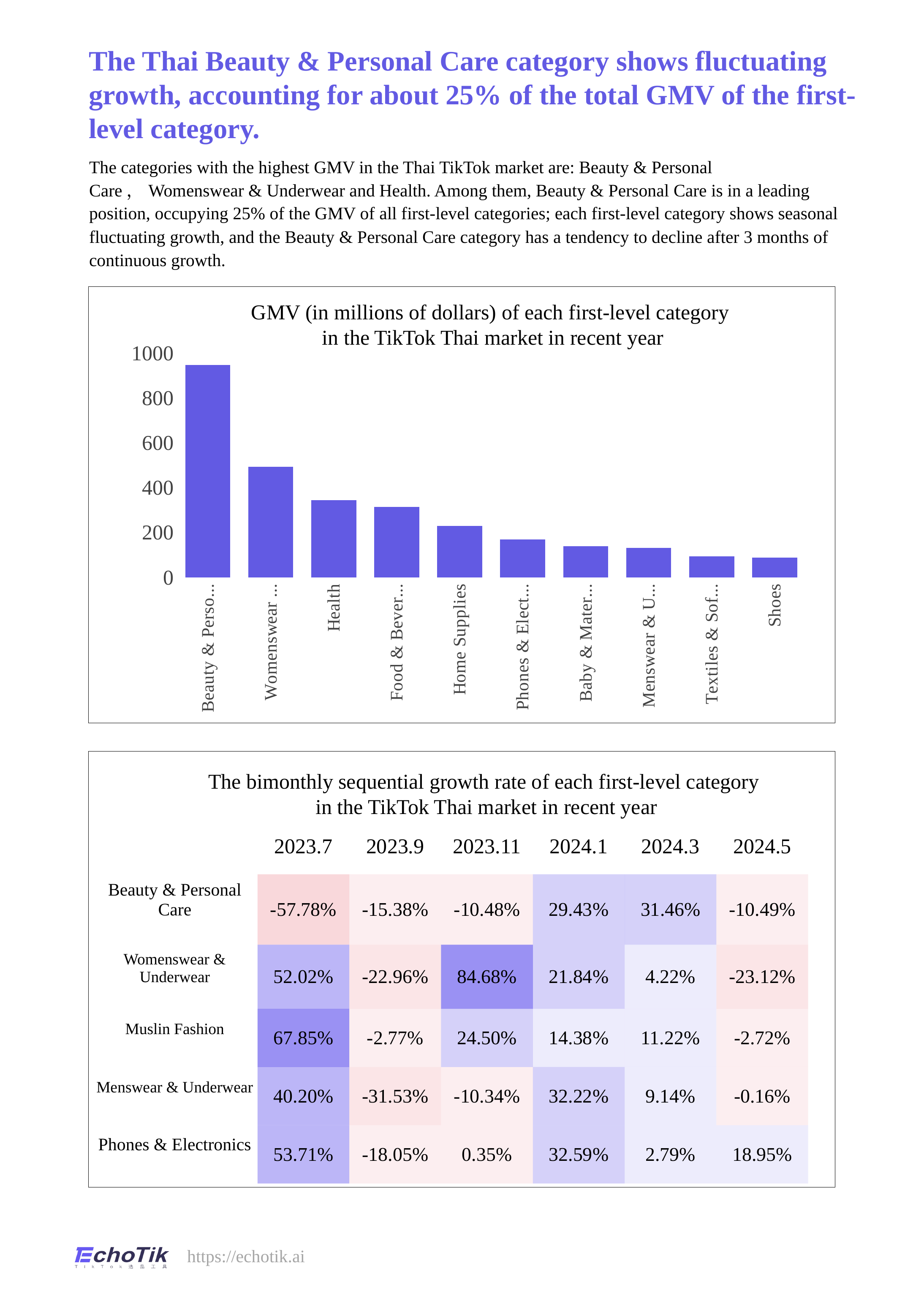
In the GMV bar chart, which category has the highest GMV? Beauty & Personal Care In the GMV bar chart, is the value for Shoes greater or less than 200? less In the bimonthly growth rate chart, which is larger for 2024.1: Menswear & Underwear or Phones & Electronics? Phones & Electronics What kind of chart is the GMV chart at the top of the slide? bar chart In the GMV bar chart, do the values rise or fall from left to right along the x axis? fall In the bimonthly growth rate chart, what is the growth rate of Beauty & Personal Care in 2023.7? -57.78% In the GMV bar chart, is the value for Beauty & Personal Care greater or less than 800? greater In the GMV bar chart, is the value for Health greater or less than 400? less In the bimonthly growth rate chart, what is the growth rate of Womenswear & Underwear in 2023.11? 84.68% In the GMV bar chart, which category has the lowest GMV? Shoes In the bimonthly growth rate chart, which category has the highest growth rate in 2024.5? Phones & Electronics How many categories are shown in the GMV bar chart? 10